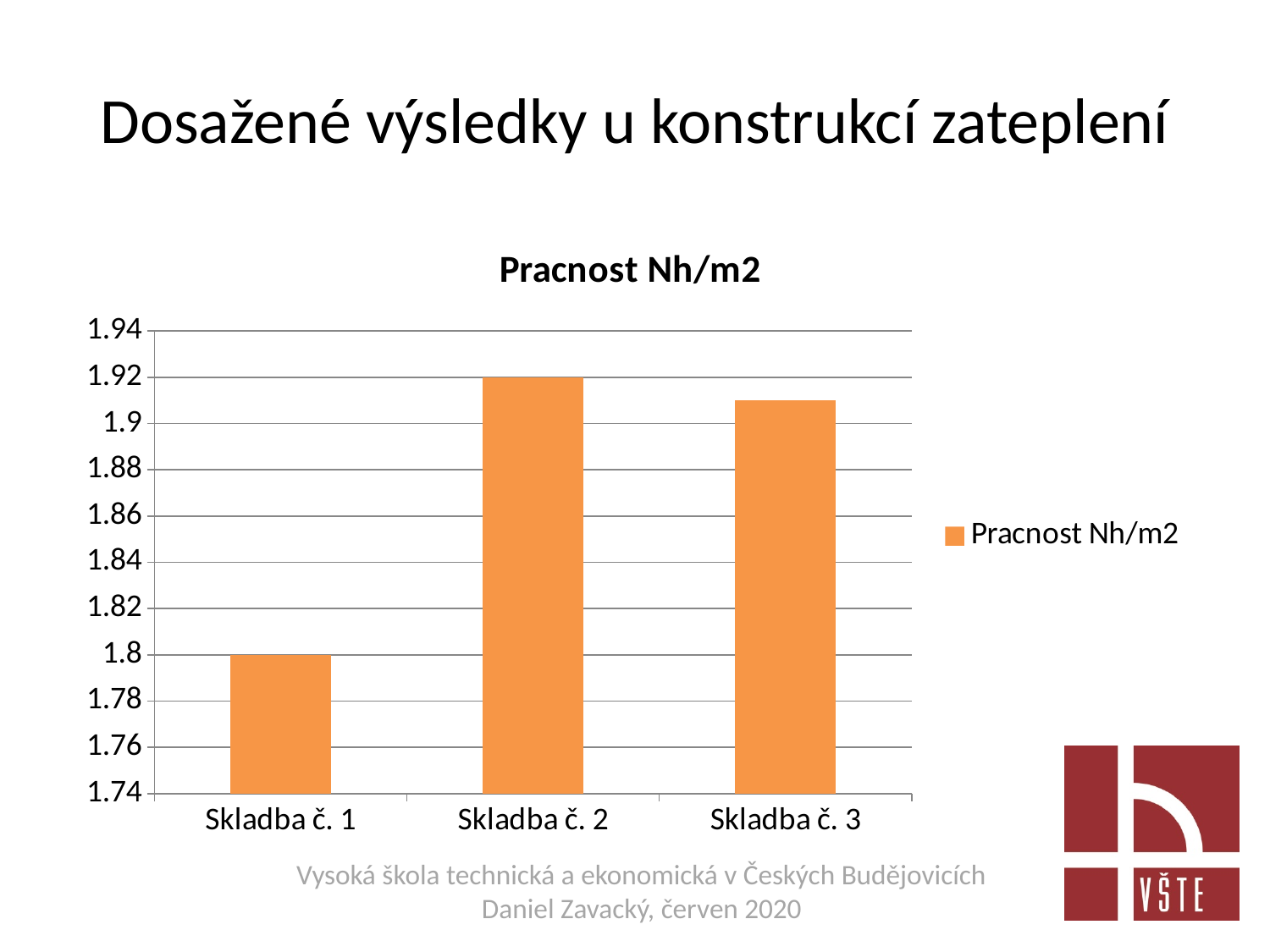
How many categories are shown on the x axis? 3 How many series does the legend list? 1 Which category has the highest value? Skladba č. 2 Which is larger, the value for Skladba č. 1 or Skladba č. 3? Skladba č. 3 What kind of chart is shown? bar chart What is the value for Skladba č. 2? 1.92 Is the value for Skladba č. 3 greater or less than 1.9? greater What is the title of the chart? Pracnost Nh/m2 Which category has the lowest value? Skladba č. 1 What is the difference between the values for Skladba č. 2 and Skladba č. 1? 0.12 Is the value for Skladba č. 1 greater or less than 1.86? less What is the value for Skladba č. 1? 1.8